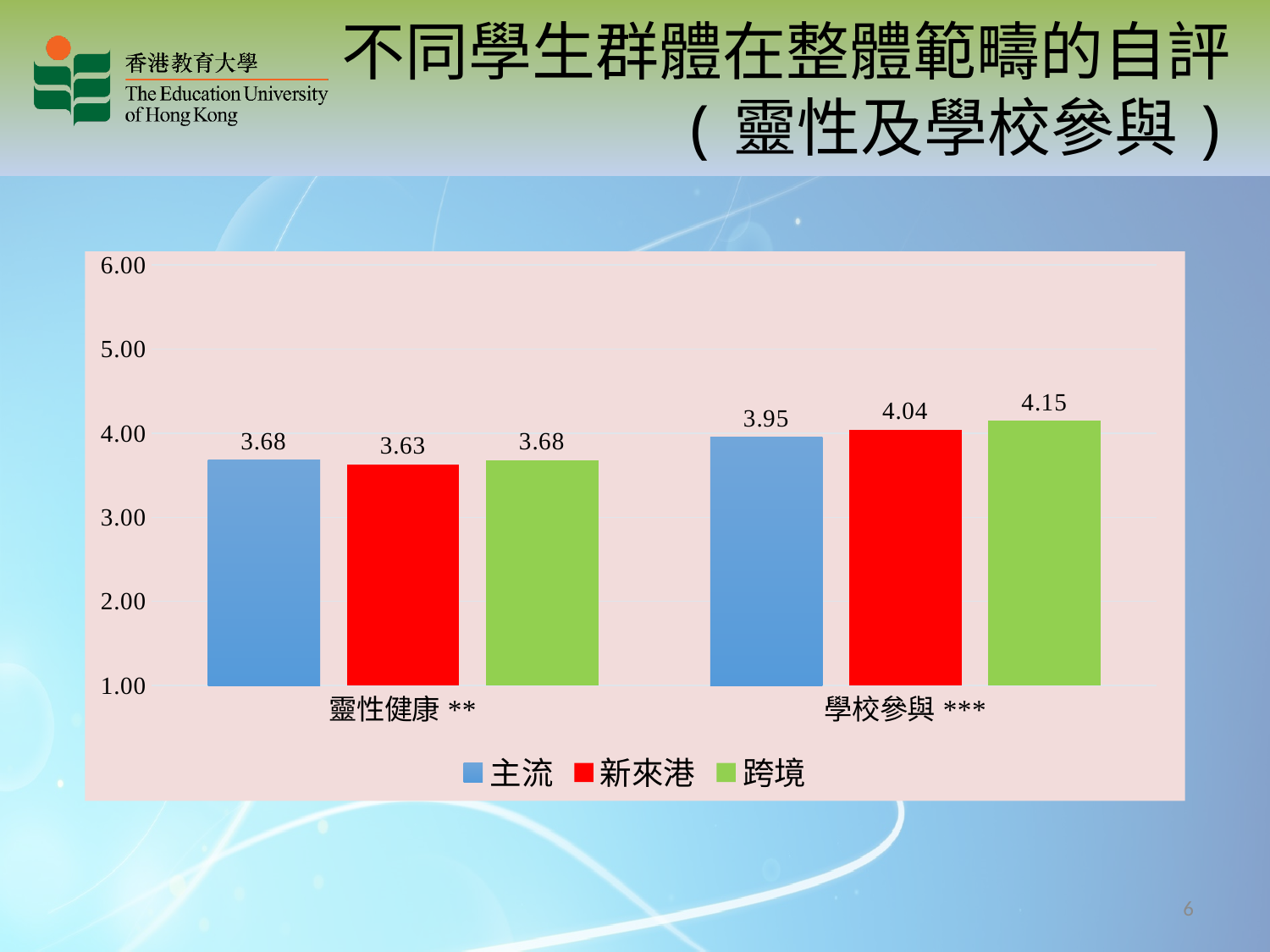
What is the value for 新來港 in the 學校參與 *** category? 4.04 Which colour represents the 新來港 series in the legend? red What is the difference between the 跨境 and 主流 values in the 學校參與 *** category? 0.20 What is the value for 主流 in the 靈性健康 ** category? 3.68 How many series does the legend list? 3 Which group has the lowest value in the 靈性健康 ** category? 新來港 Which group has the highest value in the 學校參與 *** category? 跨境 Is the value for 主流 in 學校參與 *** greater or less than 3.00? greater How many categories are shown on the x axis? 2 What kind of chart is shown on the slide? bar chart What is the value for 跨境 in the 學校參與 *** category? 4.15 Which is larger: the 新來港 value for 靈性健康 ** or the 新來港 value for 學校參與 ***? 學校參與 ***